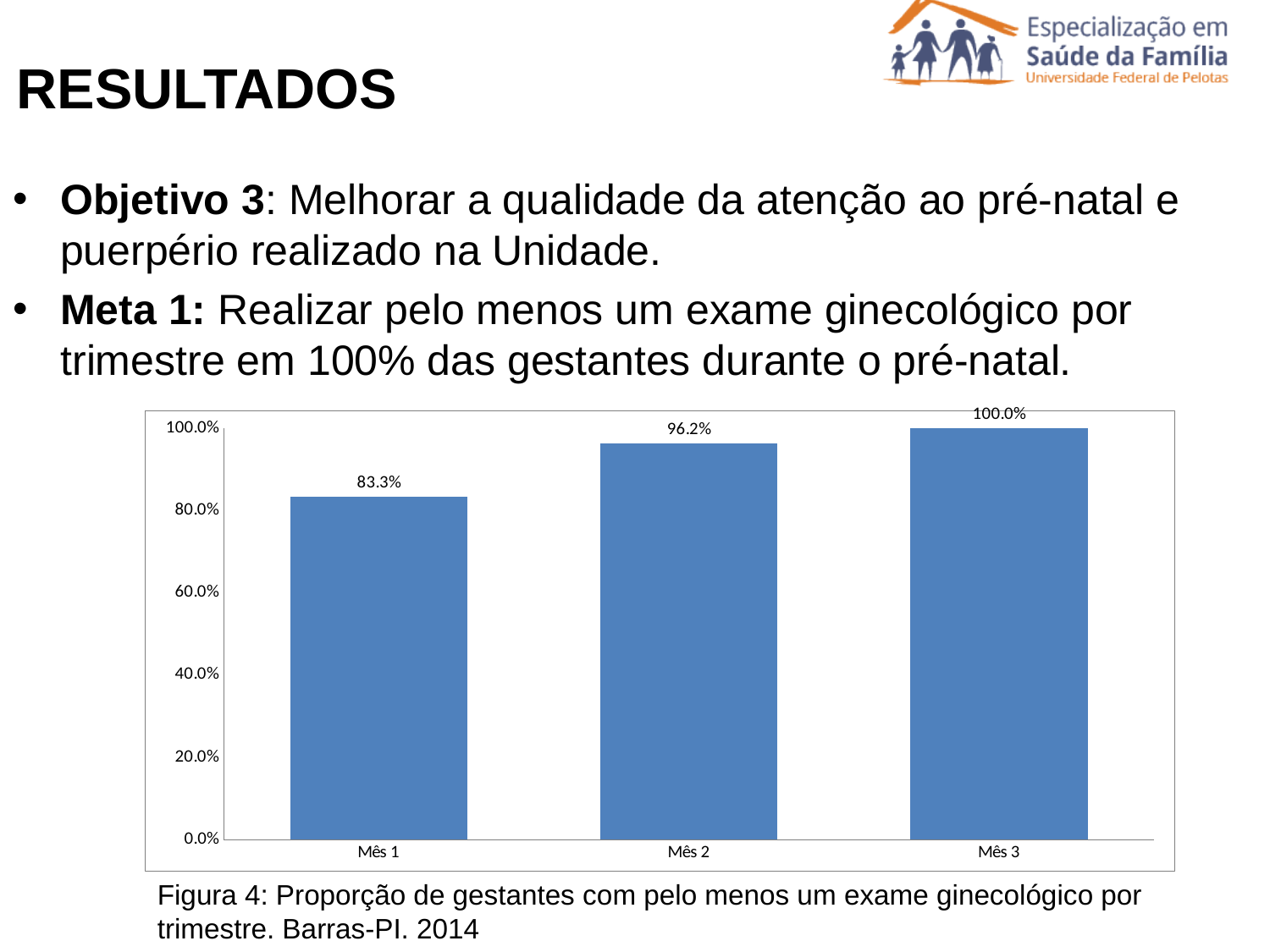
What is the value for Mês 1? 83.3% Do the values rise or fall from Mês 1 to Mês 3? rise Is the value for Mês 1 greater or less than 80.0%? greater What is the value for Mês 2? 96.2% Which is larger, the value for Mês 1 or the value for Mês 2? Mês 2 How many months are shown on the x axis? 3 Which month has the lowest value? Mês 1 What is the difference between the values for Mês 3 and Mês 1? 16.7% What is the value for Mês 3? 100.0% Which month has the highest value? Mês 3 What is the difference between the values for Mês 2 and Mês 1? 12.9% What kind of chart is shown on the slide? bar chart